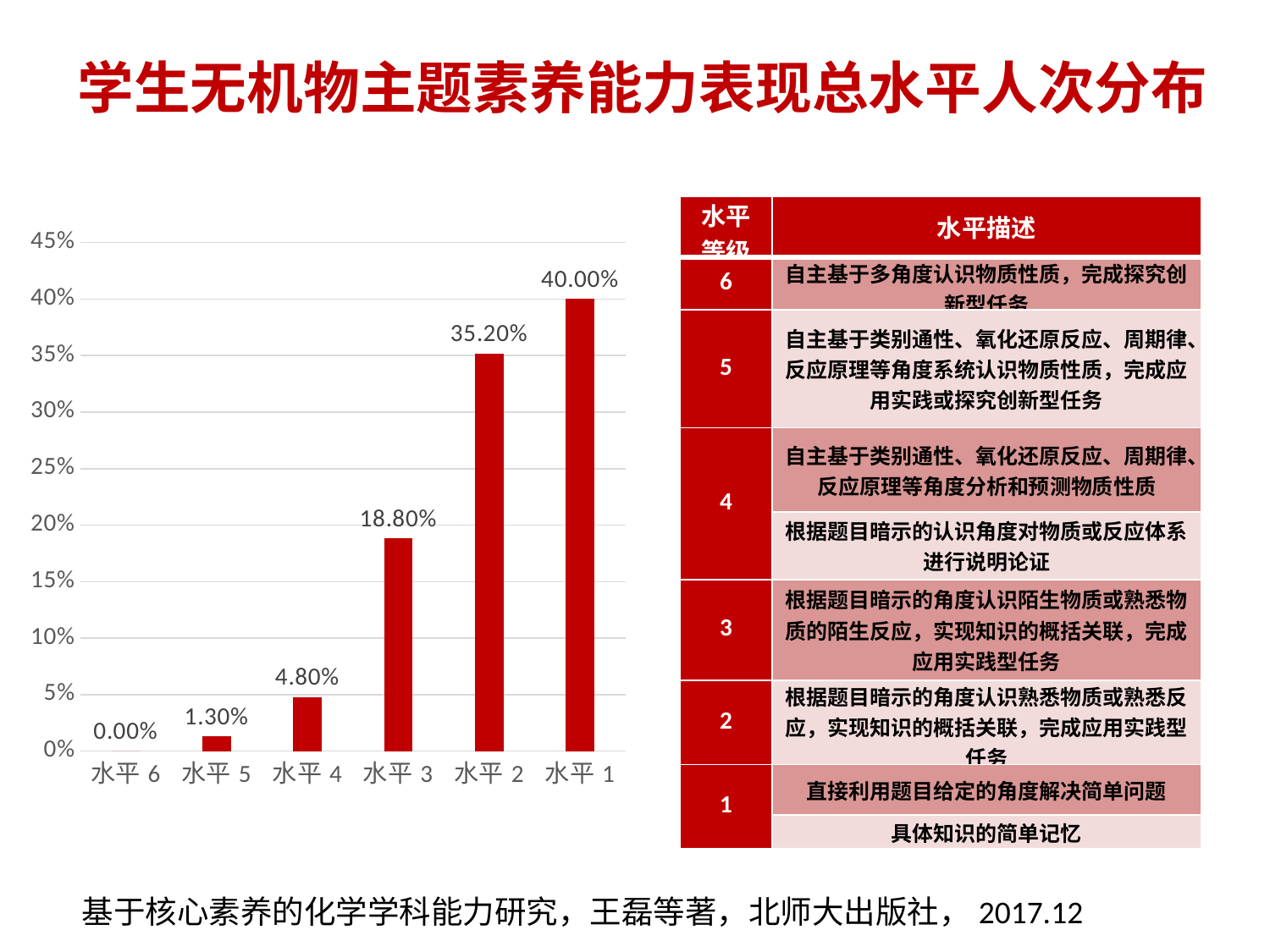
Is the value for 水平 2 greater or less than 30%? greater What is the difference between the values for 水平 3 and 水平 4? 14.00% What is the value for 水平 5? 1.30% Which is larger, the value for 水平 2 or the value for 水平 3? 水平 2 What is the value for 水平 3? 18.80% What is the value for 水平 1? 40.00% Do the values rise or fall moving from 水平 6 to 水平 1 along the x axis? rise What kind of chart is shown on the slide? bar chart Which category has the highest value? 水平 1 How many categories are shown on the x axis? 6 What is the difference between the values for 水平 1 and 水平 2? 4.80% Which category has the lowest value? 水平 6